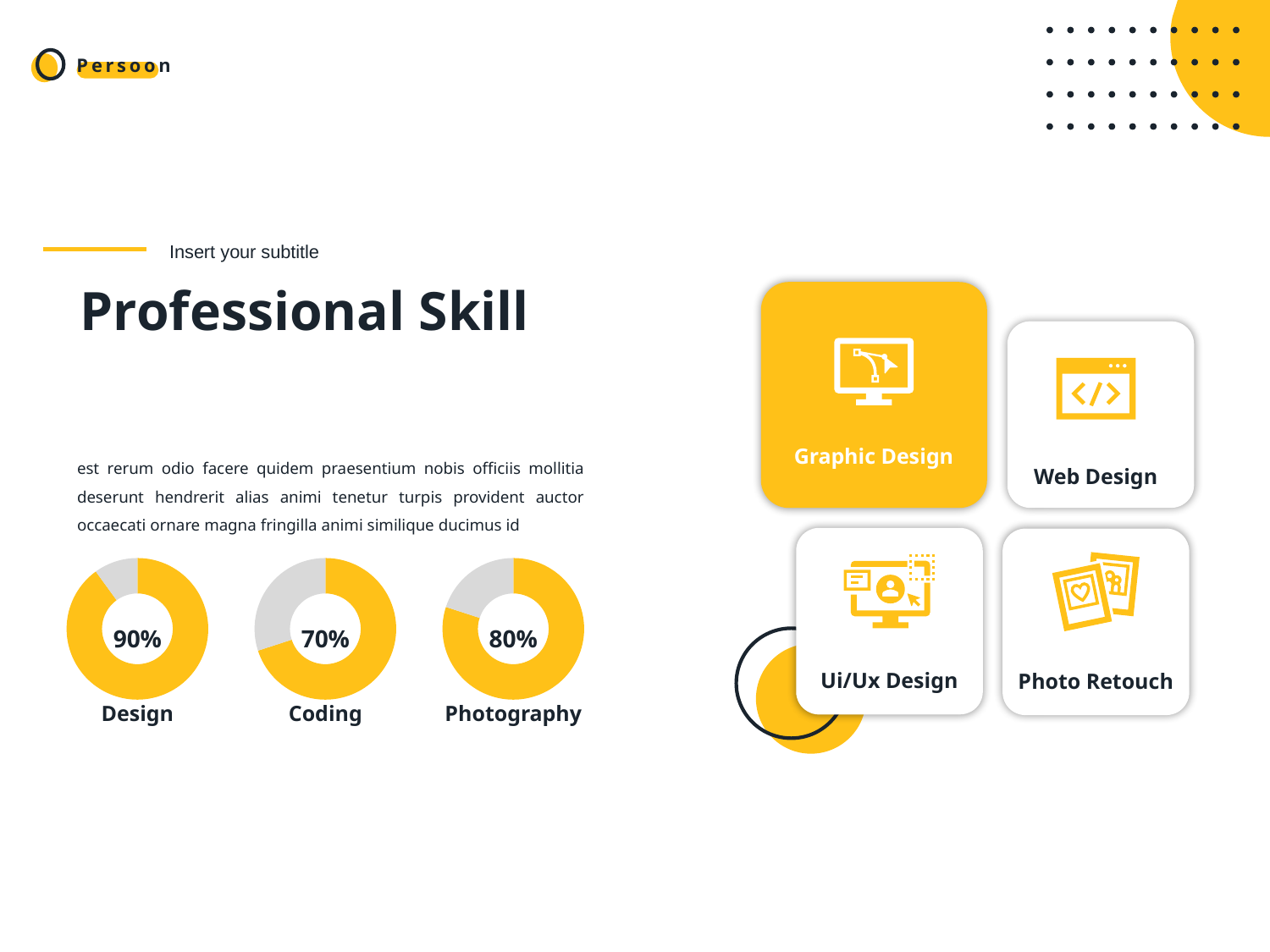
How many donut charts are shown on the slide? 3 What is the title of the slide containing the donut charts? Professional Skill What value is shown in the Photography donut chart? 80% What type of chart is used to show the Design, Coding and Photography skills? Donut chart Which of the three donut charts shows the highest percentage? Design What value is shown in the Coding donut chart? 70% What value is shown in the Design donut chart? 90% What is the difference between the Photography and Coding percentages? 10% What colour is the filled portion of each donut chart? Yellow Which of the three donut charts shows the lowest percentage? Coding Which is larger, the Photography value or the Coding value? Photography What is the difference between the Design and Coding percentages? 20%